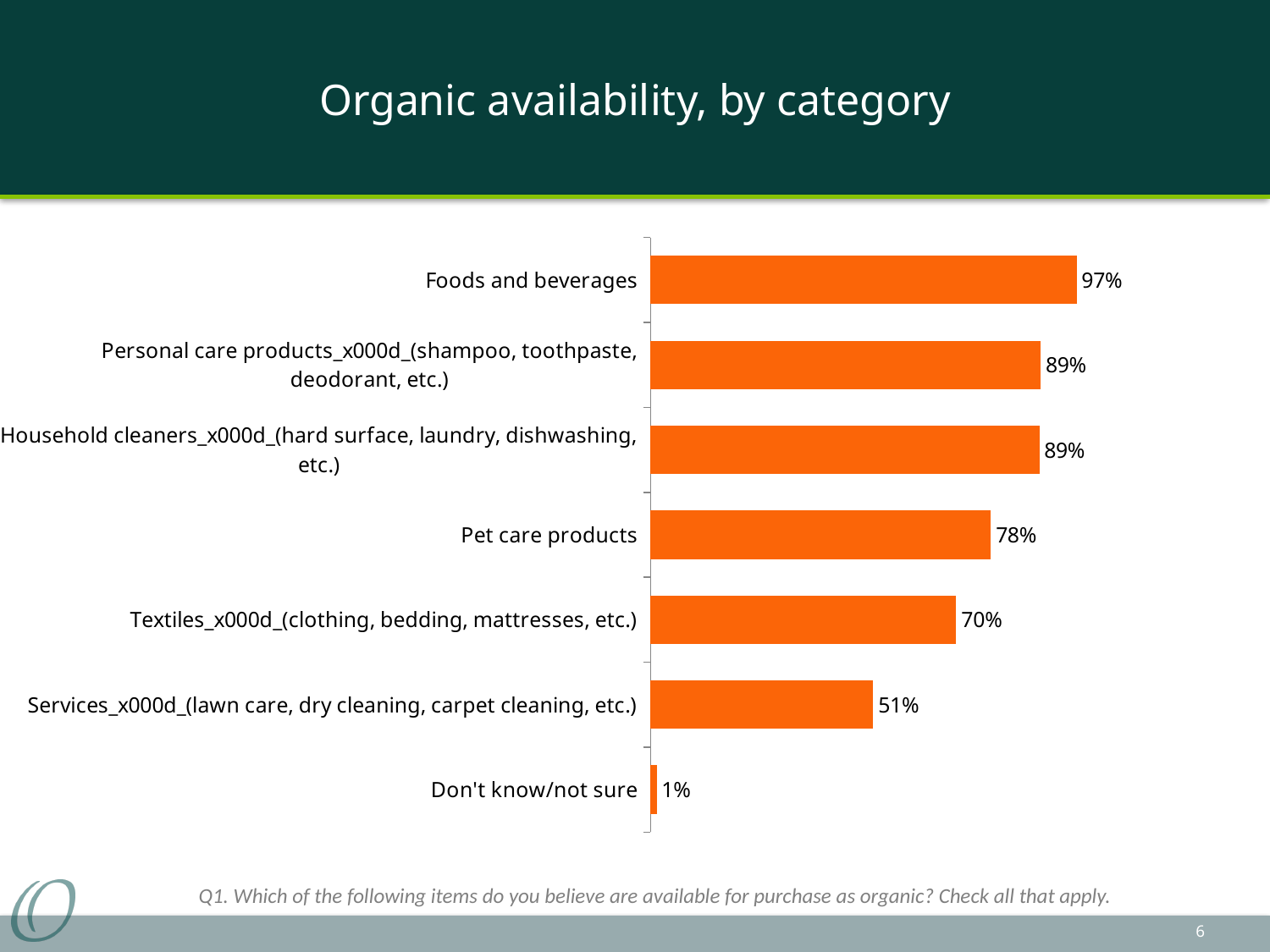
What is the value for Pet care products? 78% How many categories are shown in the chart? 7 What is the value for Don't know/not sure? 1% Which is larger, the value for Pet care products or the value for Textiles? Pet care products Which category has the highest value? Foods and beverages What is the difference between the values for Foods and beverages and Pet care products? 19% What is the difference between the values for Textiles and Services? 19% What kind of chart is shown on the slide? Bar chart What is the value for Services (lawn care, dry cleaning, carpet cleaning, etc.)? 51% What is the value for Foods and beverages? 97% Which category has the lowest value? Don't know/not sure What is the value for Textiles (clothing, bedding, mattresses, etc.)? 70%